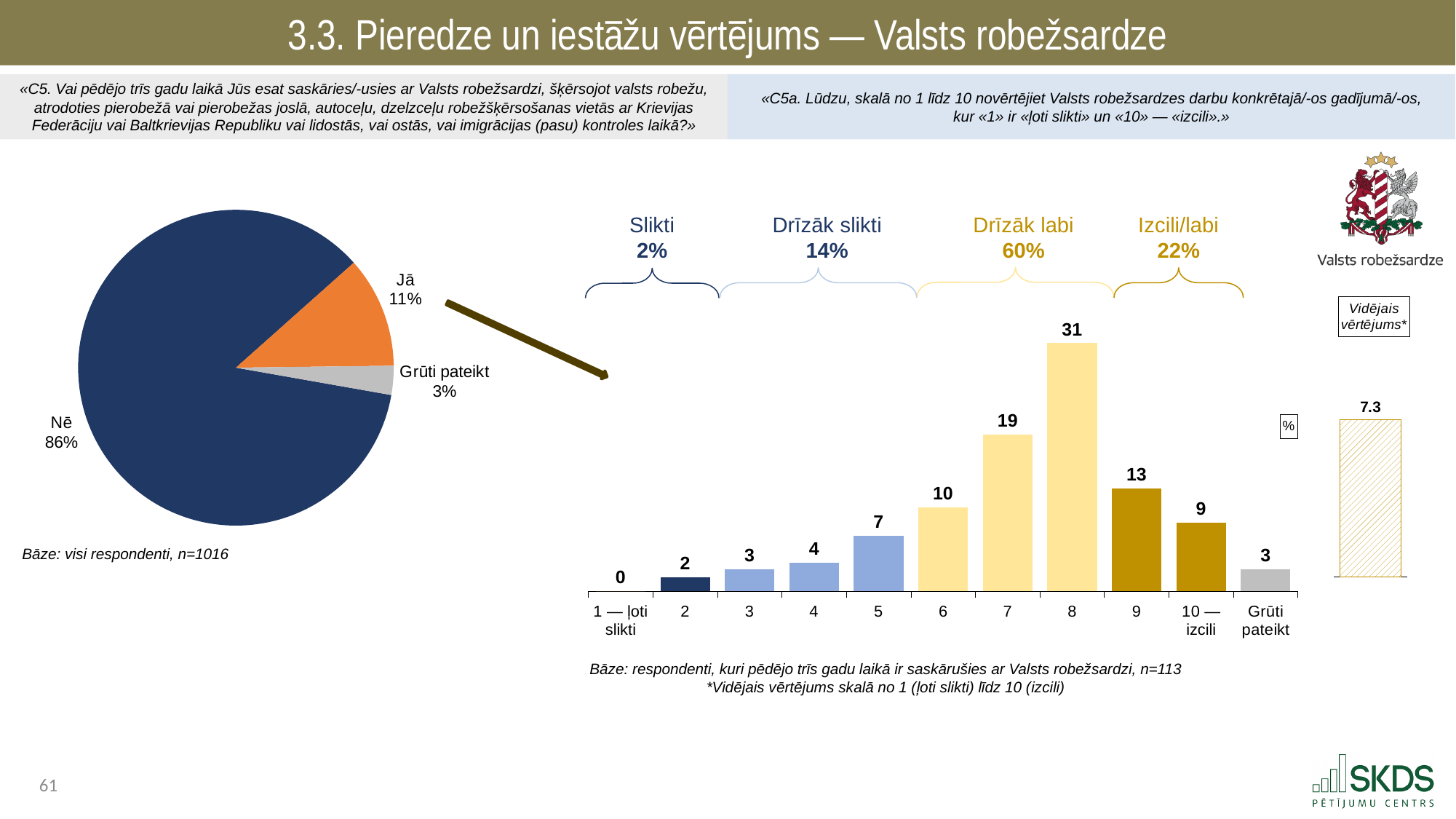
What kind of chart is the chart on the left of the slide? pie chart In the pie chart on the left, what share of respondents answered "Nē"? 86% How many bars does the bar chart in the middle have? 11 In the pie chart on the left, which answer has the smallest slice? Grūti pateikt What is the average rating (Vidējais vērtējums) shown in the small bar on the right? 7.3 In the bar chart in the middle, what is the difference between the values for rating 7 and rating 9? 6 In the bar chart in the middle, which rating has the highest value? 8 In the bar chart in the middle, which is larger: the value for rating 5 or the value for rating 6? rating 6 How many slices does the pie chart on the left have? 3 In the pie chart on the left, what share of respondents answered "Jā"? 11% In the bar chart in the middle, what is the value for "1 — ļoti slikti"? 0 In the bar chart in the middle, what is the value for rating 8? 31